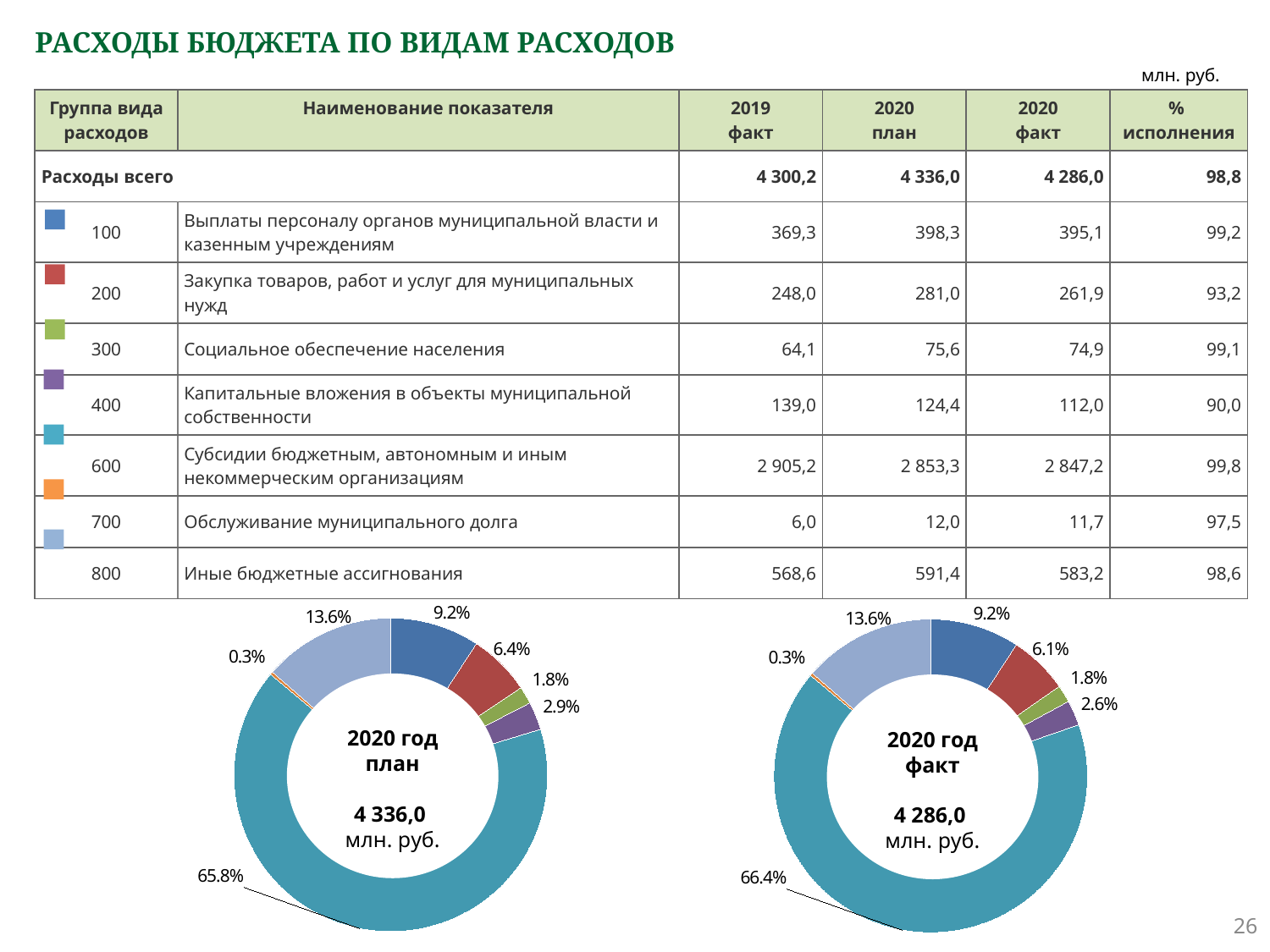
How many slices does the '2020 год план' chart contain? 7 In the '2020 год план' chart, what share is shown for the purple slice? 2.9% In the '2020 год план' chart, what share does the largest (teal) slice have? 65.8% What is the difference between the teal slice's share in the '2020 год факт' chart and in the '2020 год план' chart? 0.6% In the '2020 год факт' chart, what share does the largest (teal) slice have? 66.4% What total value is printed in the centre of the '2020 год факт' chart? 4 286,0 млн. руб. In the '2020 год факт' chart, which slice has the smallest share? The orange slice, 0.3% In the '2020 год факт' chart, what share is shown for the red slice? 6.1% Which is larger: the red slice in the '2020 год план' chart or the red slice in the '2020 год факт' chart? The '2020 год план' chart (6.4%) What type of chart is used for the '2020 год план' chart on the left? Pie (donut) chart What total value is printed in the centre of the '2020 год план' chart? 4 336,0 млн. руб. In the '2020 год план' chart, what share is shown for the dark blue slice? 9.2%